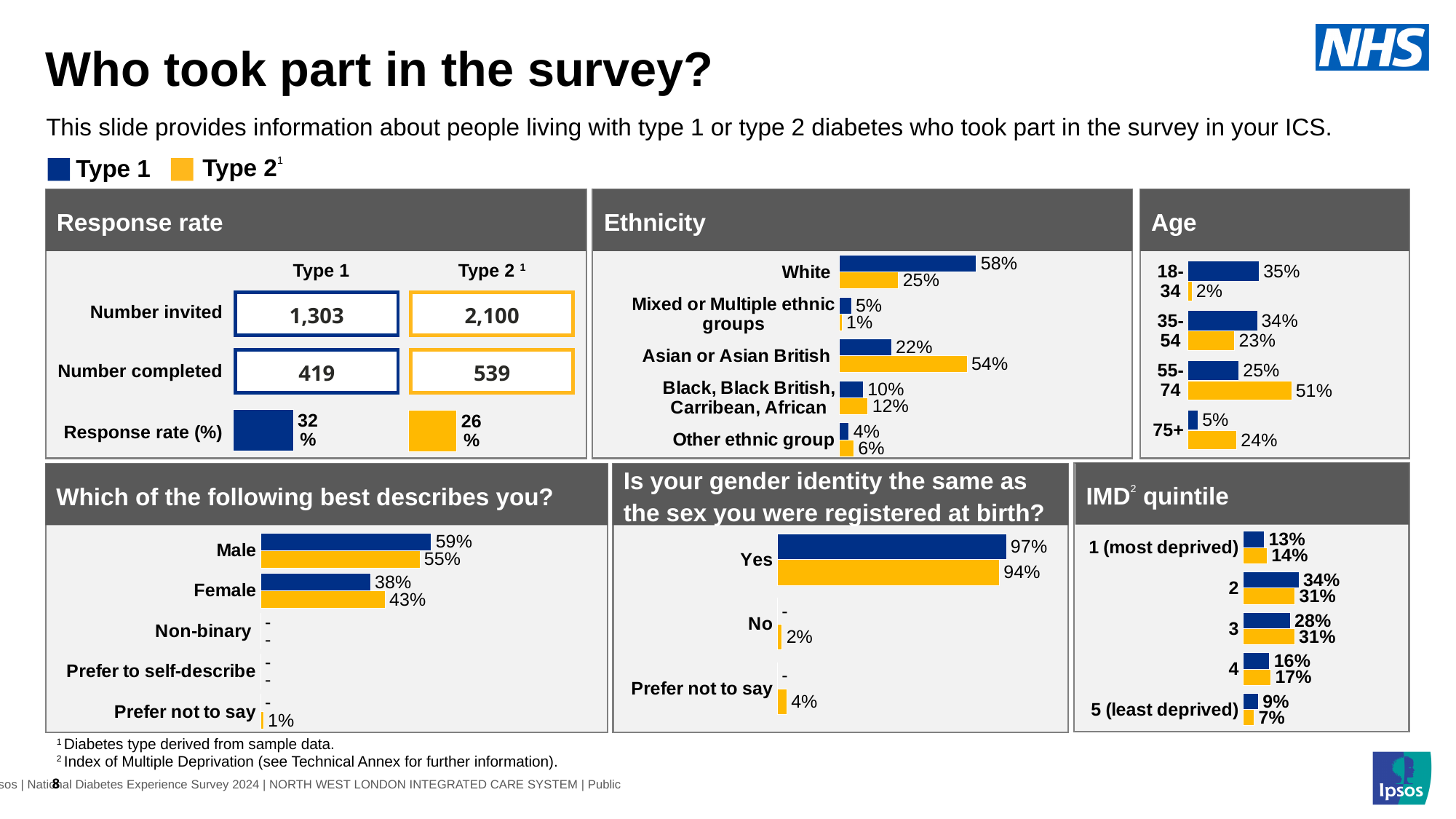
In the IMD quintile chart, what is the difference between the Type 1 and Type 2 values for quintile 3? 3 percentage points How many series does the legend at the top of the slide list? 2 In the IMD quintile chart, which quintile has the highest Type 1 percentage? 2 In the Response rate panel, what is the number of Type 2 respondents who completed the survey? 539 In the Age chart, what is the Type 2 value for the 55-74 age group? 51% In the 'Which of the following best describes you?' chart, what is the Type 2 value for Female? 43% In the gender identity chart, what is the Type 1 value for Yes? 97% In the 'Which of the following best describes you?' chart, is the Type 1 value for Male larger or smaller than the Type 2 value for Male? larger In the Ethnicity chart, which ethnic group has the highest Type 1 percentage? White In the Ethnicity chart, what percentage of Type 2 respondents are Asian or Asian British? 54% In the Age chart, what is the difference between the Type 1 and Type 2 values for the 18-34 age group? 33 percentage points In the Age chart, which age group has the lowest Type 1 percentage? 75+